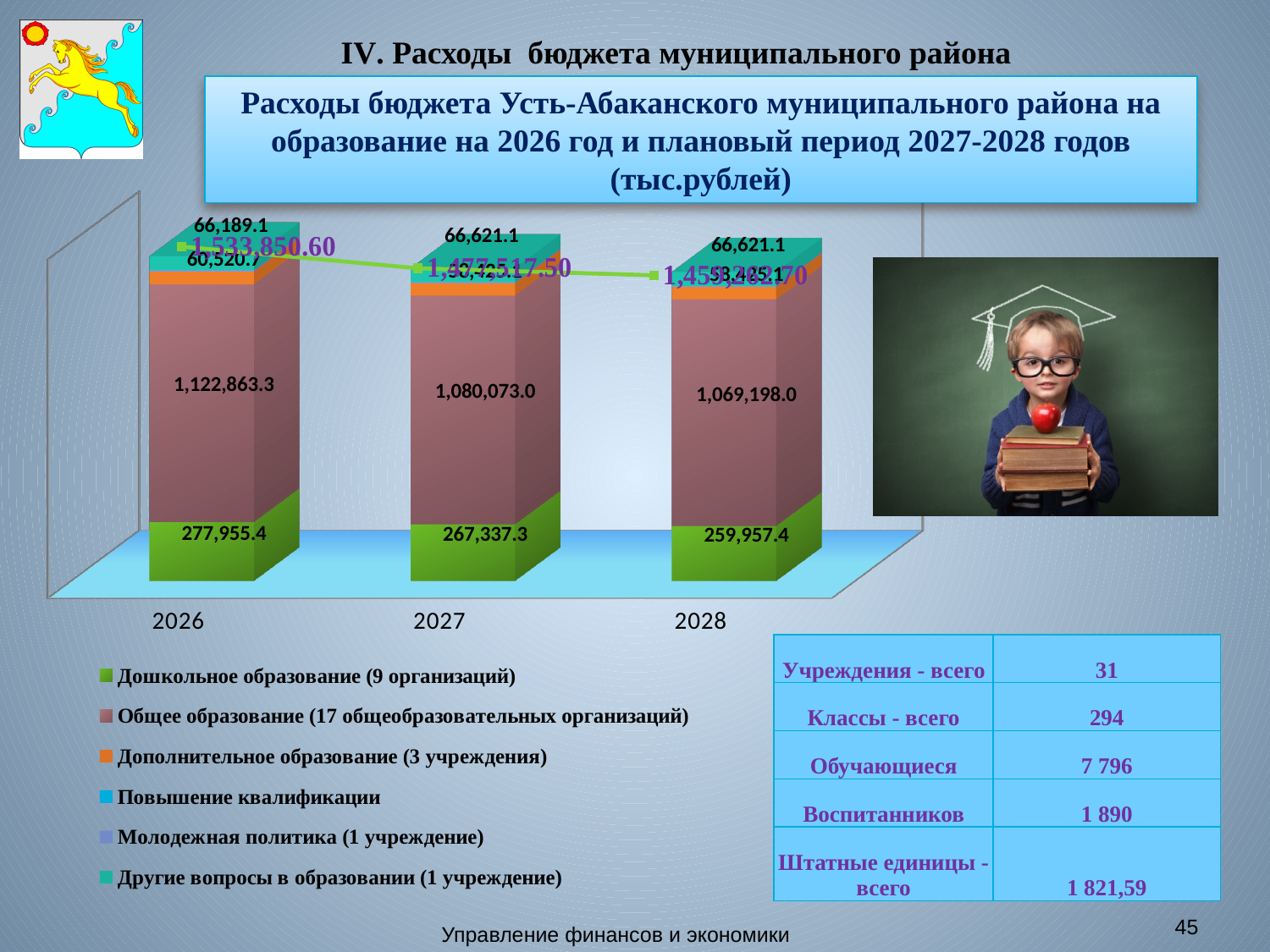
In which year is the value for Общее образование the highest? 2026 What is the value for Общее образование in 2027? 1,080,073.0 How many years are shown on the x axis of the chart? 3 What is the value for Общее образование in 2028? 1,069,198.0 Which year has the larger value for Общее образование, 2027 or 2028? 2027 What is the value for Дошкольное образование in 2026? 277,955.4 What kind of chart is shown on the slide? Stacked bar chart How many series does the legend list? 6 What is the value for Дошкольное образование in 2028? 259,957.4 In which year is the value for Дошкольное образование the lowest? 2028 What is the difference between the Дошкольное образование values for 2026 and 2027? 10,618.1 What is the total shown on the line for 2026? 1,533,850.60